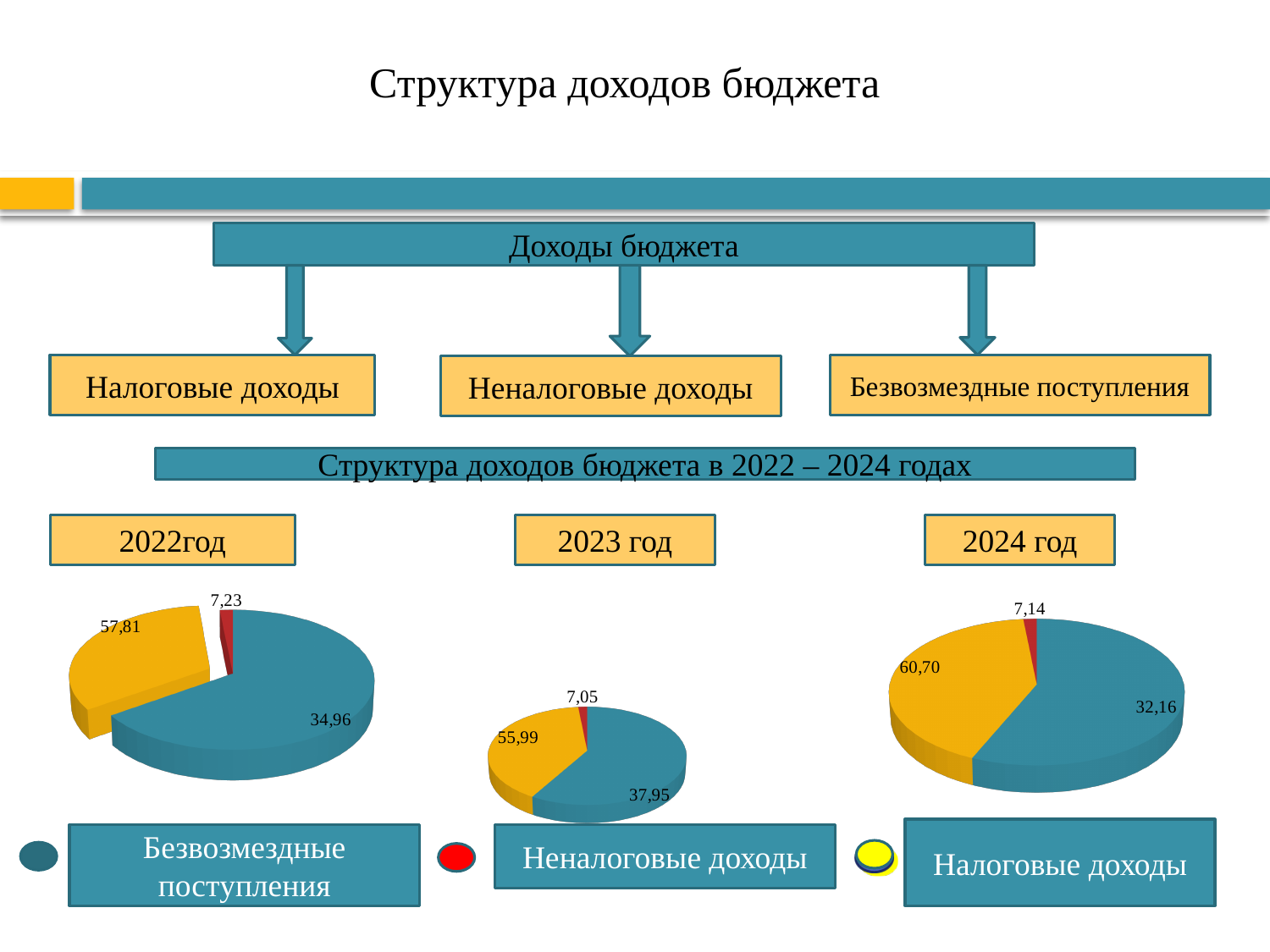
In the 2022 pie chart, which category has the smallest slice? Неналоговые доходы How many slices does the 2023 pie chart have? 3 What colour represents Налоговые доходы in the pie charts? Yellow Across the 2022, 2023 and 2024 pie charts, does the value for Неналоговые доходы stay below 10 in every year? Yes In the 2023 pie chart, what is the difference between the Налоговые доходы value and the Безвозмездные поступления value? 18,04 In the 2024 pie chart, what is the value for Неналоговые доходы (red slice)? 7,14 In the 2022 pie chart, what is the value for Налоговые доходы (yellow slice)? 57,81 Comparing the 2022 and 2024 pie charts, which year has the larger value for Безвозмездные поступления? 2022 What type of chart is used for the 2022, 2023 and 2024 data? Pie chart How many categories does the legend below the charts list? 3 In the 2023 pie chart, what is the value for Безвозмездные поступления (teal slice)? 37,95